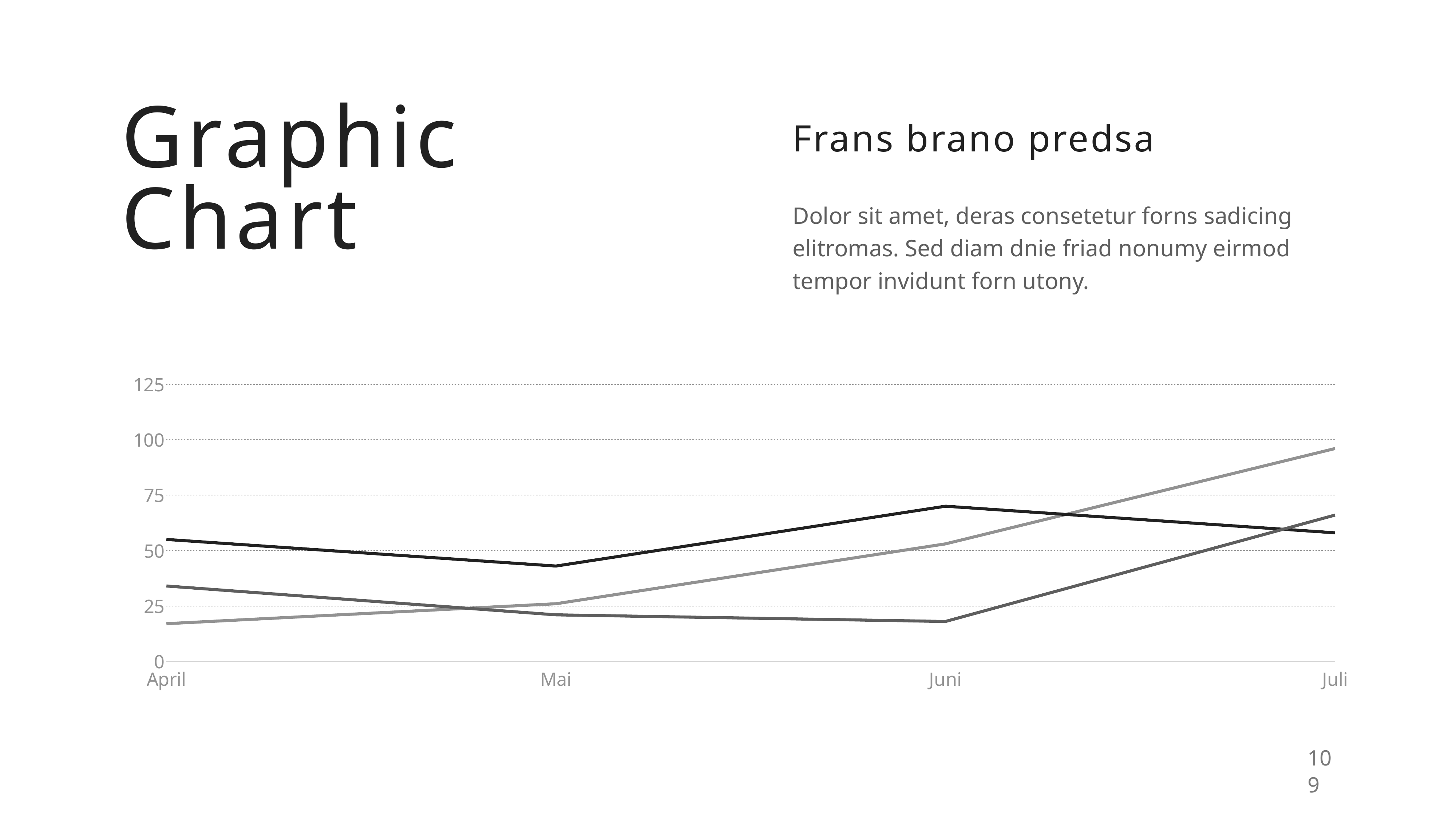
Is the value of the dark gray line in Juni greater or less than 25? less How many lines are plotted on the chart? 3 Is the value of the black line in Mai greater or less than 50? less Is the value of the black line in Juni greater or less than 50? greater What kind of chart is shown on the slide? line chart How many months are shown on the x axis of the chart? 4 In Juni, which line is higher: the black line or the light gray line? the black line In which month does the light gray line reach its highest value? Juli Does the light gray line rise or fall from April to Juli? rise